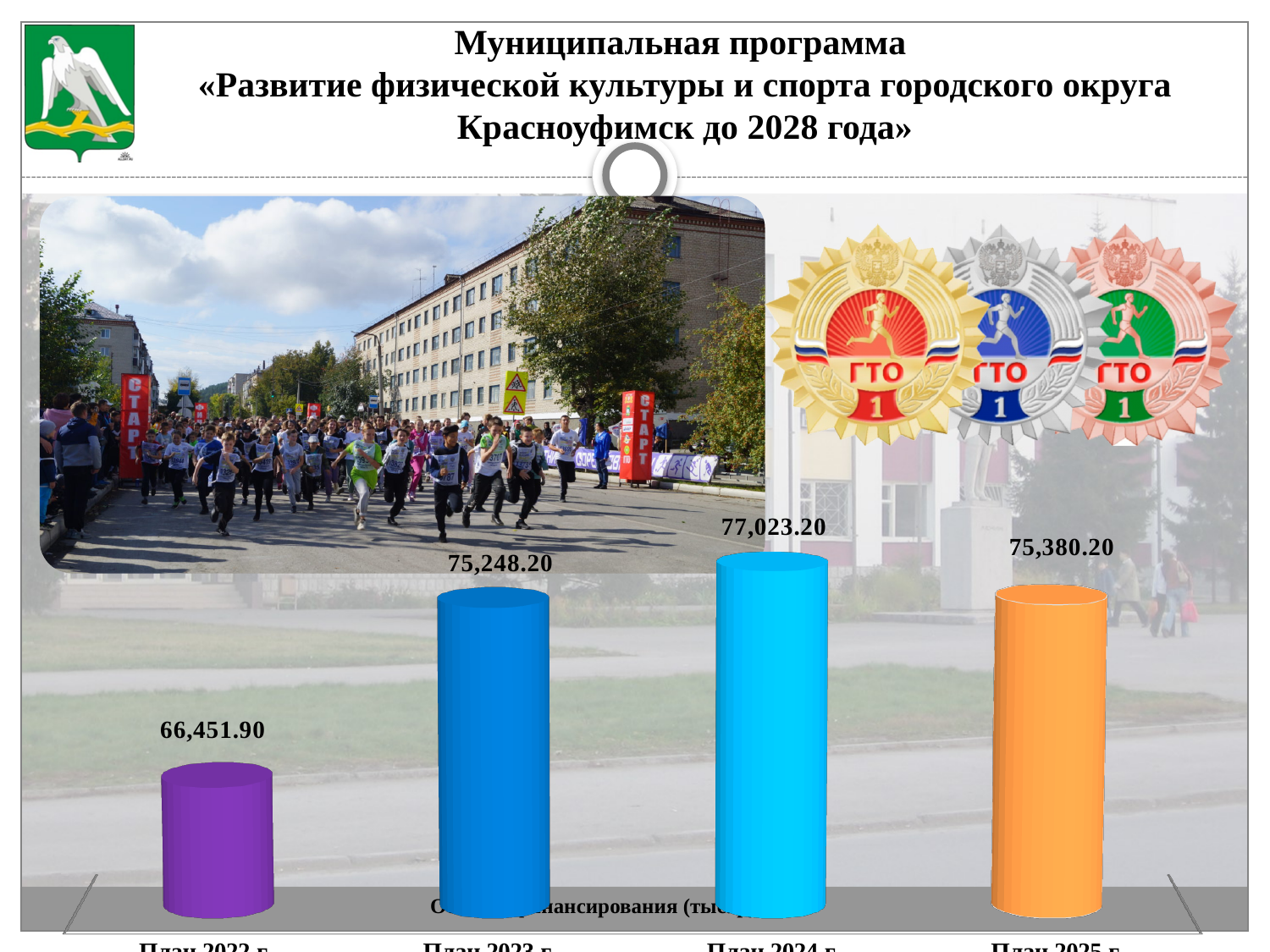
How many categories are shown in the chart? 4 What is the value for План 2023 г.? 75,248.20 What is the difference between the values for План 2023 г. and План 2022 г.? 8,796.30 What is the value for План 2024 г.? 77,023.20 What is the difference between the values for План 2024 г. and План 2022 г.? 10,571.30 Which category has the lowest value? План 2022 г. What is the value for План 2022 г.? 66,451.90 What is the value for План 2025 г.? 75,380.20 Do the values rise or fall from План 2022 г. to План 2024 г.? Rise What kind of chart is shown on the slide? Bar chart Which is larger, the value for План 2023 г. or the value for План 2022 г.? План 2023 г. Which category has the highest value? План 2024 г.